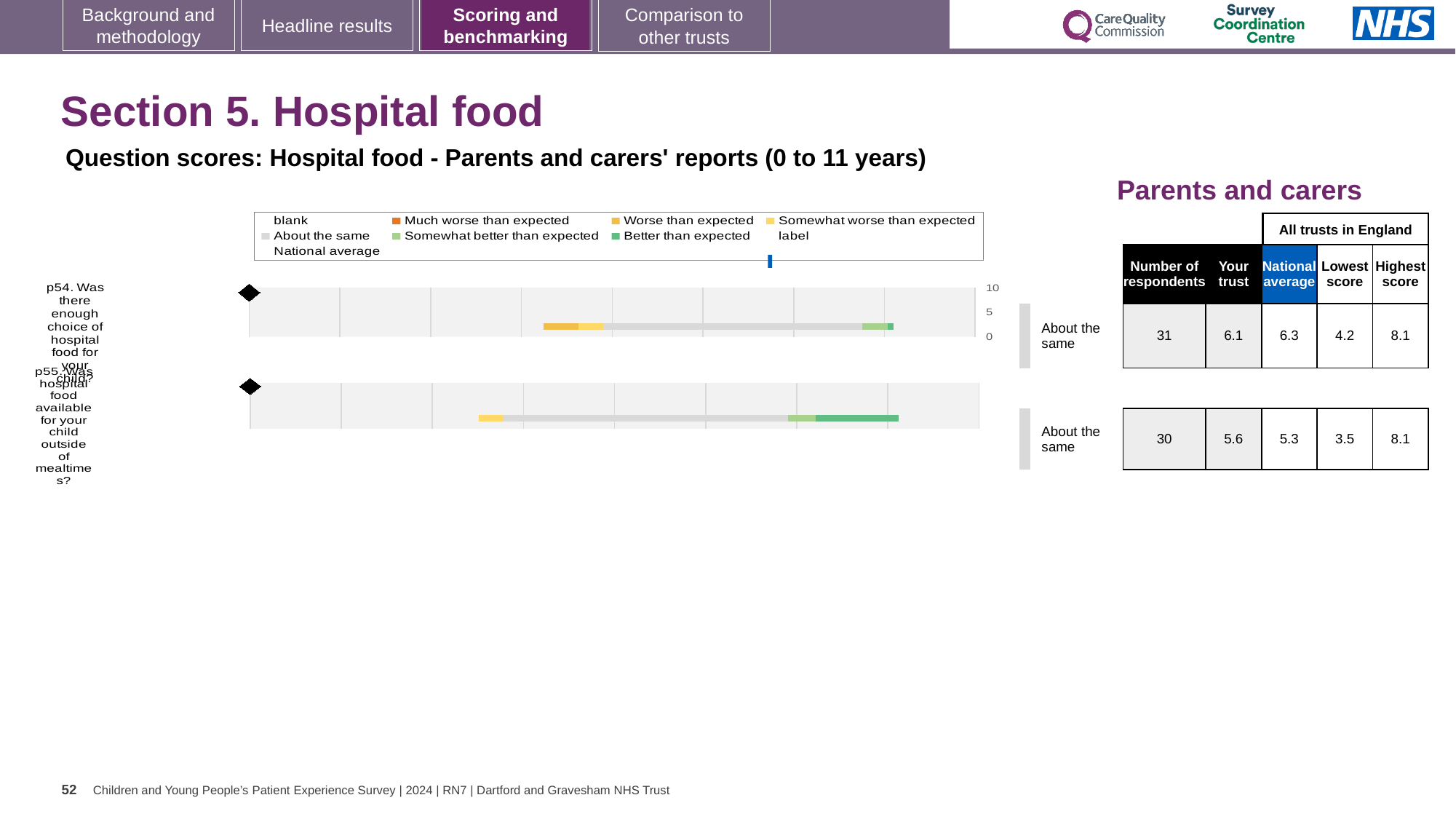
What is the difference between the highest score and the lowest score for p55? 4.6 For p55, which is higher: the 'Your trust' score or the national average? Your trust What is the subtitle of the chart on this slide? Question scores: Hospital food - Parents and carers' reports (0 to 11 years) How many questions (categories) are plotted in the hospital food chart? 2 Which question has the higher 'Your trust' score, p54 or p55? p54 What kind of chart is used to show the question scores for hospital food? Horizontal bar chart What benchmark category is shown for p55? About the same For p54, which is higher: the 'Your trust' score or the national average? National average What is the difference between the highest score and the lowest score for p54? 3.9 What is the national average score for p55 (Was hospital food available for your child outside of mealtimes?)? 5.3 What is the 'Your trust' score for p54 (Was there enough choice of hospital food for your child?)? 6.1 How many respondents answered p54? 31